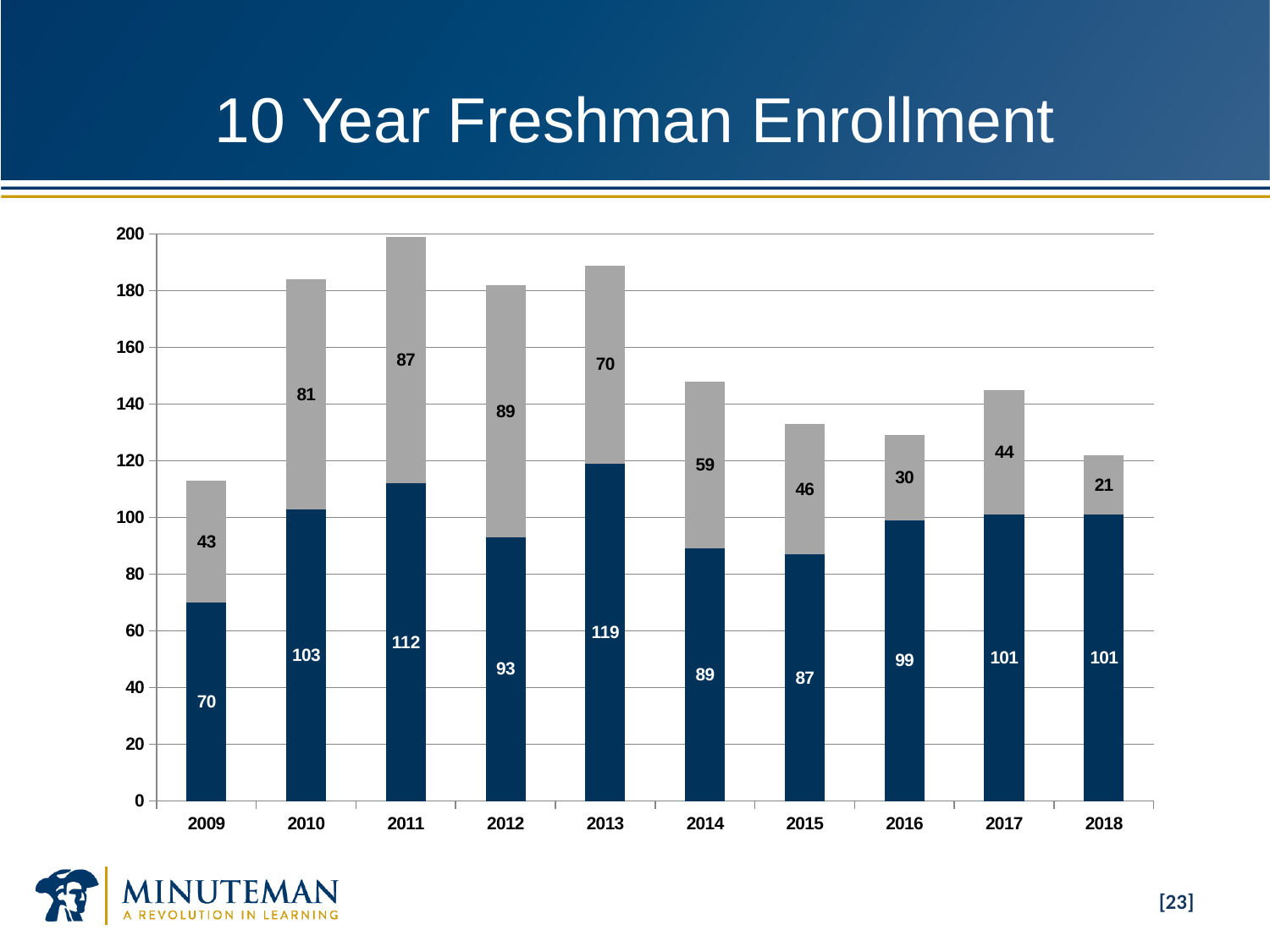
How many years are shown on the x axis? 10 What is the total of the stacked bar for 2010? 184 What is the value of the gray segment for 2016? 30 Is the total height of the 2011 bar greater or less than 180? greater Which is larger, the gray segment for 2012 or the gray segment for 2014? 2012 Which year has the lowest gray segment value? 2018 What is the difference between the dark blue segment values for 2011 and 2009? 42 What is the value of the dark blue segment for 2013? 119 Do the gray segment values rise or fall from 2013 to 2016? Fall What is the title of the chart? 10 Year Freshman Enrollment Which year has the highest dark blue segment value? 2013 What kind of chart is shown on the slide? Stacked bar chart